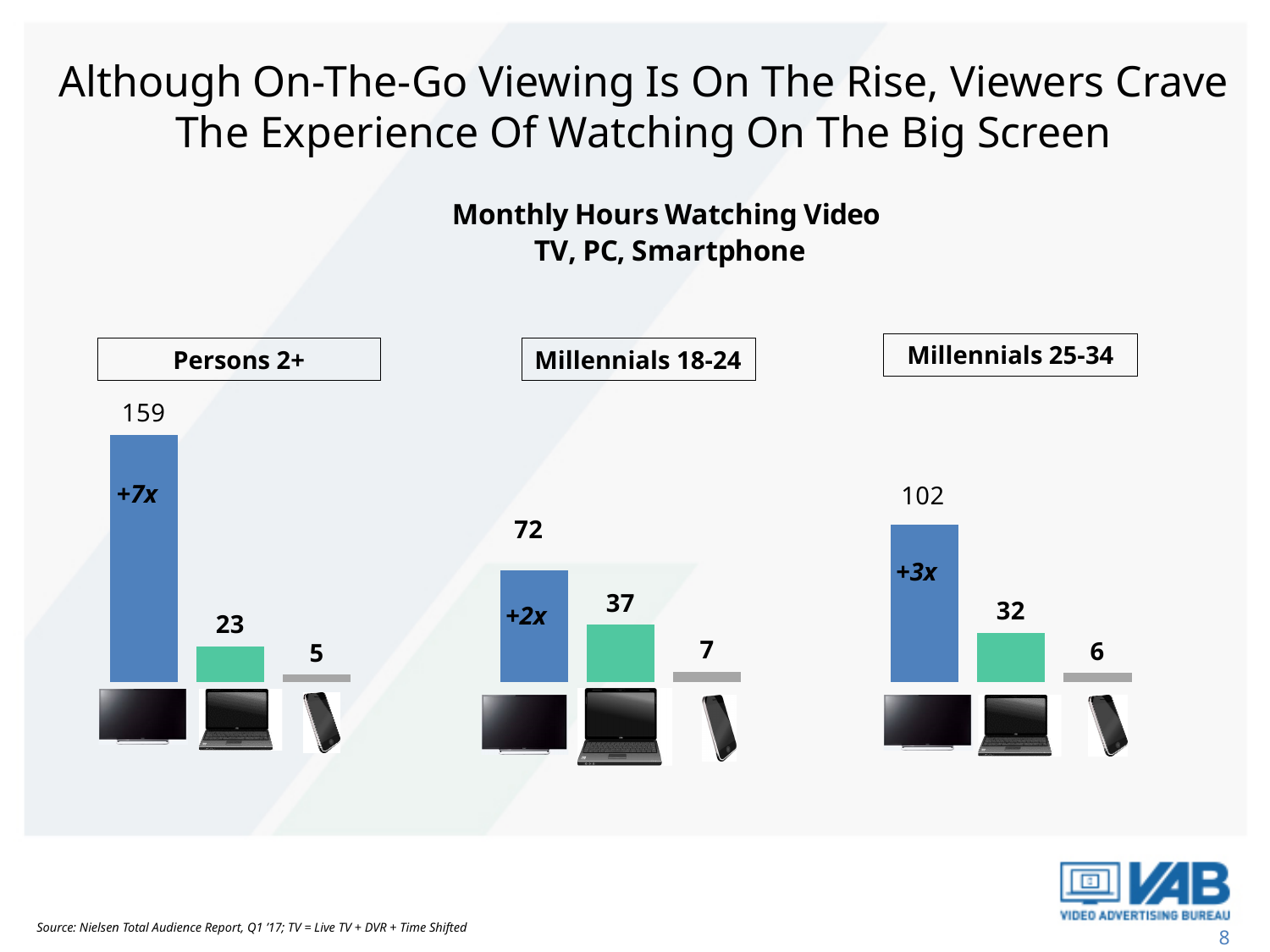
How many devices (bars) are shown in the Persons 2+ chart? 3 What is the title shown above the three charts? Monthly Hours Watching Video TV, PC, Smartphone Which is larger: TV monthly hours for Millennials 18-24 or TV monthly hours for Millennials 25-34? Millennials 25-34 In the Persons 2+ chart, how many monthly hours are spent watching video on TV? 159 In the Millennials 25-34 chart, which device has the highest monthly hours? TV In the Persons 2+ chart, what is the difference in monthly hours between TV and PC? 136 In the Millennials 18-24 chart, what is the difference in monthly hours between PC and smartphone? 30 In the Millennials 18-24 chart, which device has the lowest monthly hours? Smartphone In the Persons 2+ chart, what multiplier label is printed on the TV bar? +7x In the Millennials 25-34 chart, how many monthly hours are spent watching video on a smartphone? 6 What type of chart is used for the Millennials 18-24 group? Bar chart In the Millennials 18-24 chart, how many monthly hours are spent watching video on a PC? 37